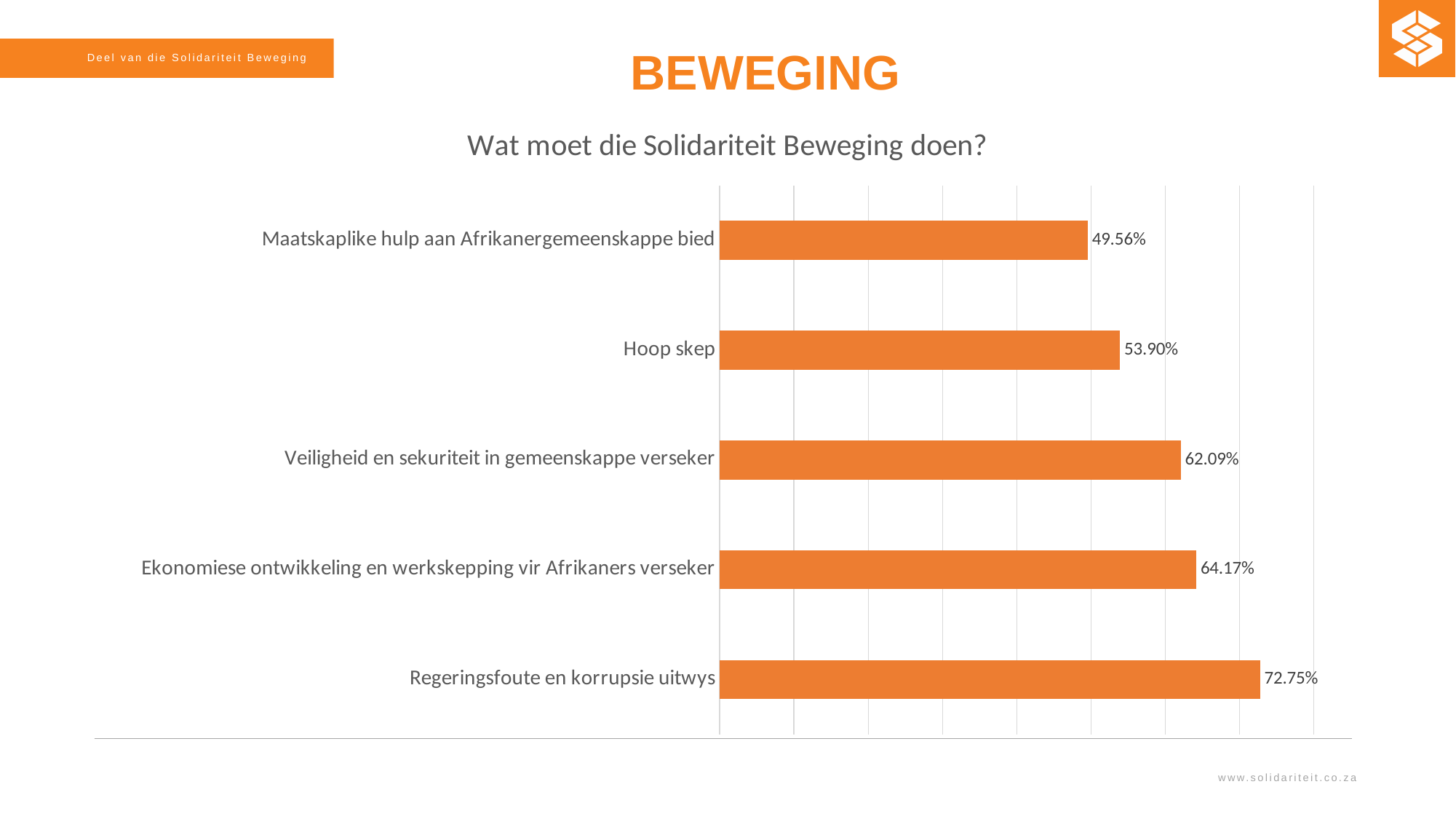
What is the difference between the values for "Ekonomiese ontwikkeling en werkskepping vir Afrikaners verseker" and "Veiligheid en sekuriteit in gemeenskappe verseker"? 2.08% Which is larger: the value for "Hoop skep" or the value for "Maatskaplike hulp aan Afrikanergemeenskappe bied"? Hoop skep Which category has the highest value? Regeringsfoute en korrupsie uitwys Which category has the lowest value? Maatskaplike hulp aan Afrikanergemeenskappe bied What is the value for "Regeringsfoute en korrupsie uitwys"? 72.75% What kind of chart is shown on the slide? Bar chart What is the value for "Maatskaplike hulp aan Afrikanergemeenskappe bied"? 49.56% What is the difference between the values for "Regeringsfoute en korrupsie uitwys" and "Hoop skep"? 18.85% How many categories are shown in the chart? 5 What is the title of the chart? Wat moet die Solidariteit Beweging doen? What is the value for "Veiligheid en sekuriteit in gemeenskappe verseker"? 62.09% What is the value for "Hoop skep"? 53.90%